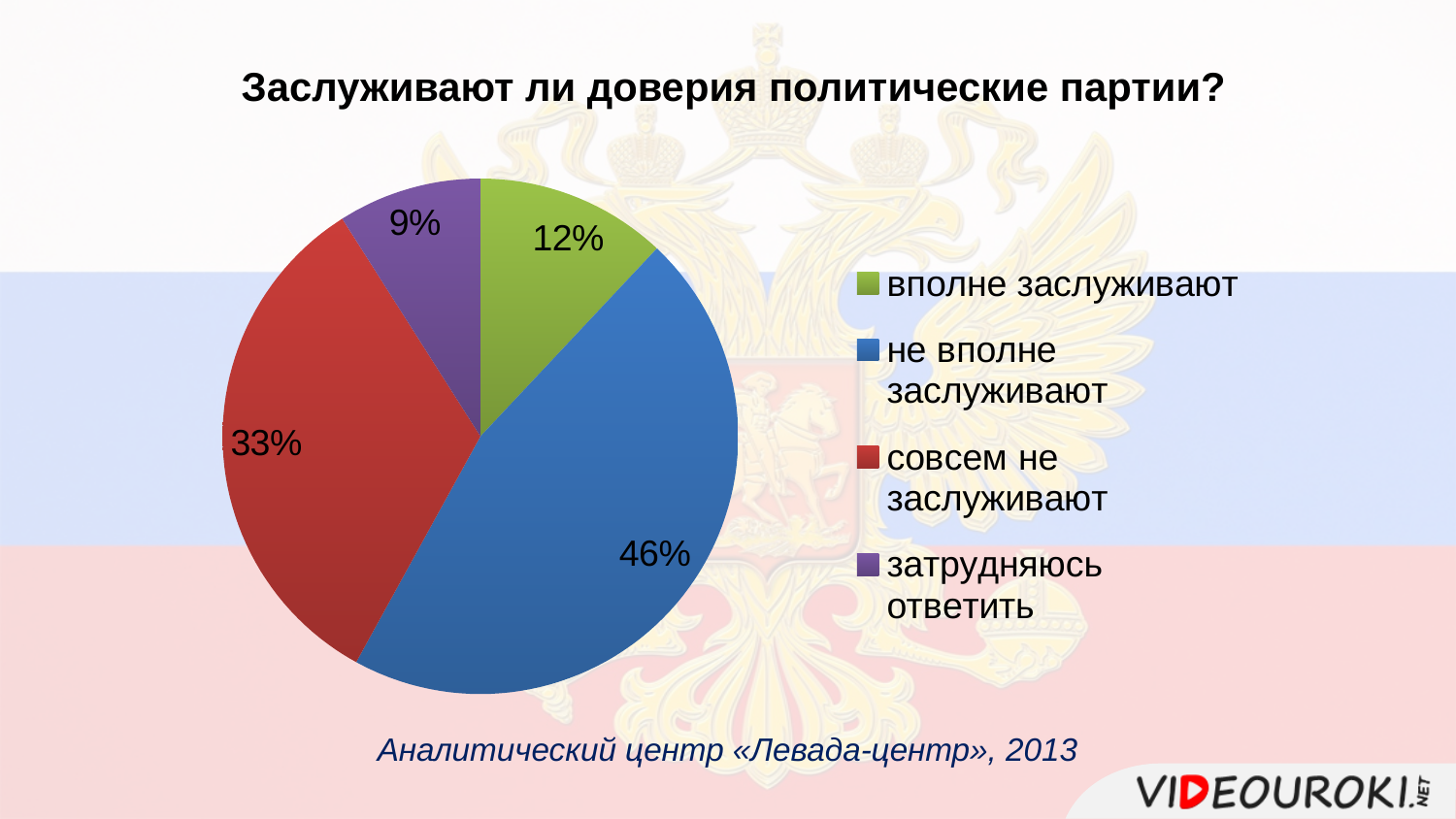
What share of respondents answered «затрудняюсь ответить»? 9% Which answer option has the largest share of the pie? не вполне заслуживают How many slices does the pie chart have? 4 What share of respondents answered «не вполне заслуживают»? 46% What share of respondents answered «вполне заслуживают»? 12% What is the difference in percentage points between «не вполне заслуживают» and «совсем не заслуживают»? 13 What colour is the slice for «совсем не заслуживают»? red Which is larger: the share for «вполне заслуживают» or the share for «затрудняюсь ответить»? вполне заслуживают What is the title of the chart? Заслуживают ли доверия политические партии? What share of respondents answered «совсем не заслуживают»? 33% What kind of chart is shown on the slide? pie chart Which answer option has the smallest share of the pie? затрудняюсь ответить